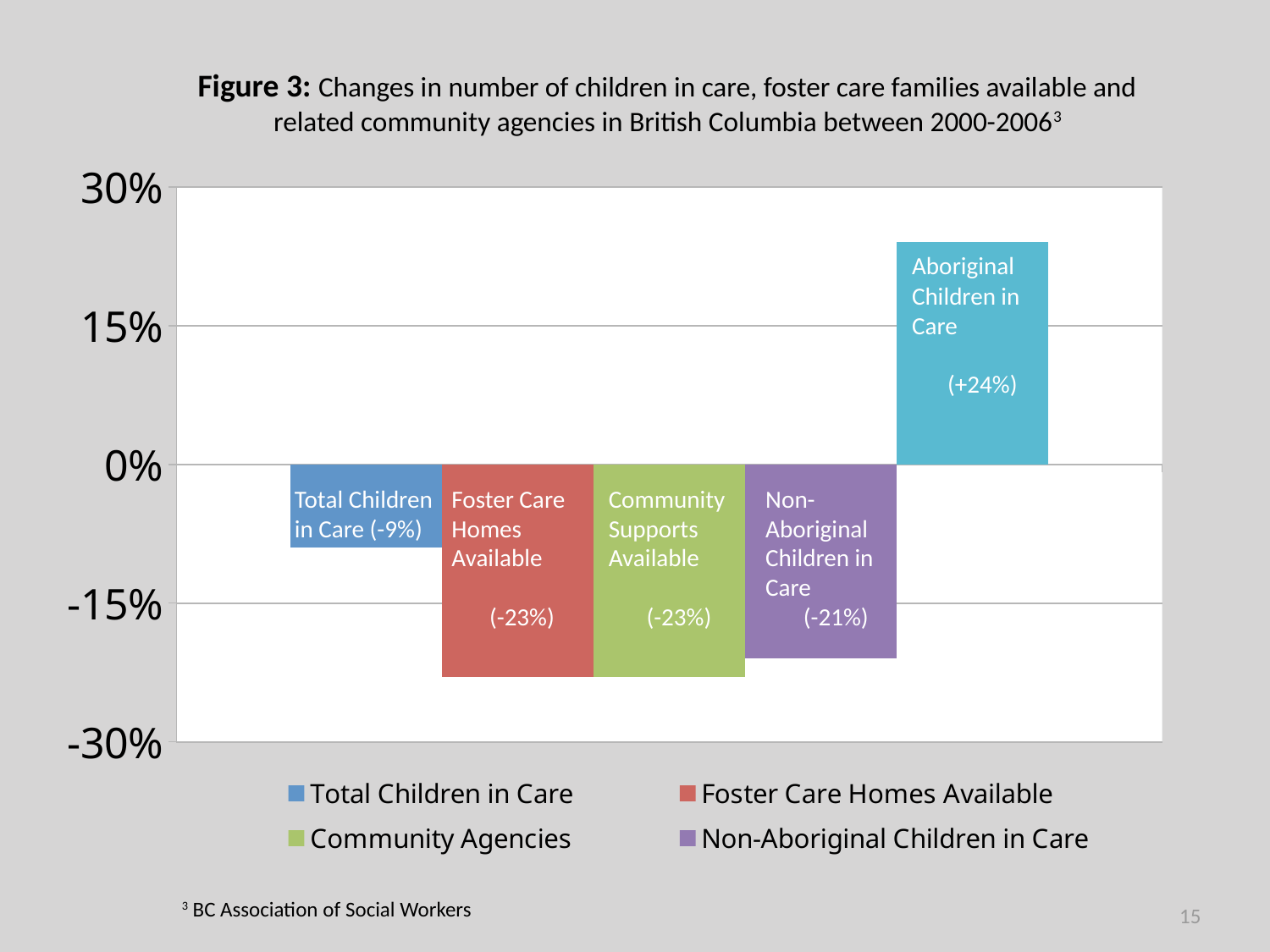
What is the value shown for Foster Care Homes Available? -23% What is the value shown for Aboriginal Children in Care? +24% What kind of chart is shown on the slide? Bar chart What is the value shown for Non-Aboriginal Children in Care? -21% How many bars are plotted in the chart? 5 Which is larger, the value for Total Children in Care or the value for Non-Aboriginal Children in Care? Total Children in Care How many entries does the legend list? 4 Is the value for Aboriginal Children in Care greater or less than 15%? greater Which category has the highest value? Aboriginal Children in Care What is the difference between the value for Aboriginal Children in Care and the value for Non-Aboriginal Children in Care? 45 percentage points Which category has the smallest decline (the value closest to zero among the negative bars)? Total Children in Care What is the value shown for Total Children in Care? -9%